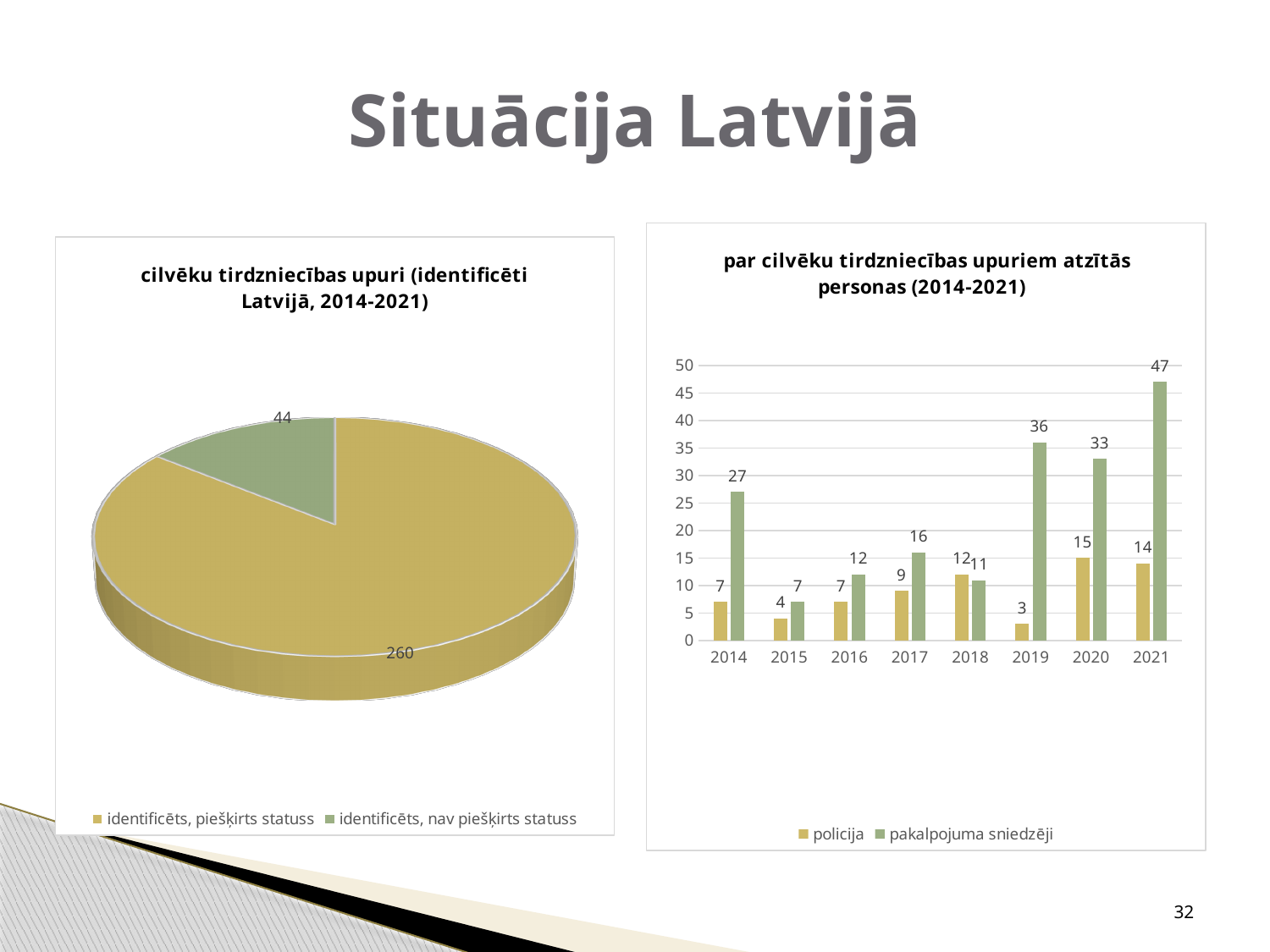
In the right bar chart, how many series does the legend list? 2 In the right bar chart, which year has the lowest value for "policija"? 2019 What kind of chart is the right chart titled "par cilvēku tirdzniecības upuriem atzītās personas (2014-2021)"? bar chart What kind of chart is the left chart titled "cilvēku tirdzniecības upuri (identificēti Latvijā, 2014-2021)"? pie chart In the right bar chart, which year has the highest value for "pakalpojuma sniedzēji"? 2021 In the right bar chart, how many years are shown on the x axis? 8 In the right bar chart, what is the value for "pakalpojuma sniedzēji" in 2021? 47 In the right bar chart, what is the difference between "pakalpojuma sniedzēji" and "policija" in 2014? 20 In the left pie chart, what is the value for "identificēts, piešķirts statuss"? 260 In the left pie chart, what is the value for "identificēts, nav piešķirts statuss"? 44 In the left pie chart, what is the total of the two slices? 304 In the right bar chart, what is the value for "policija" in 2019? 3